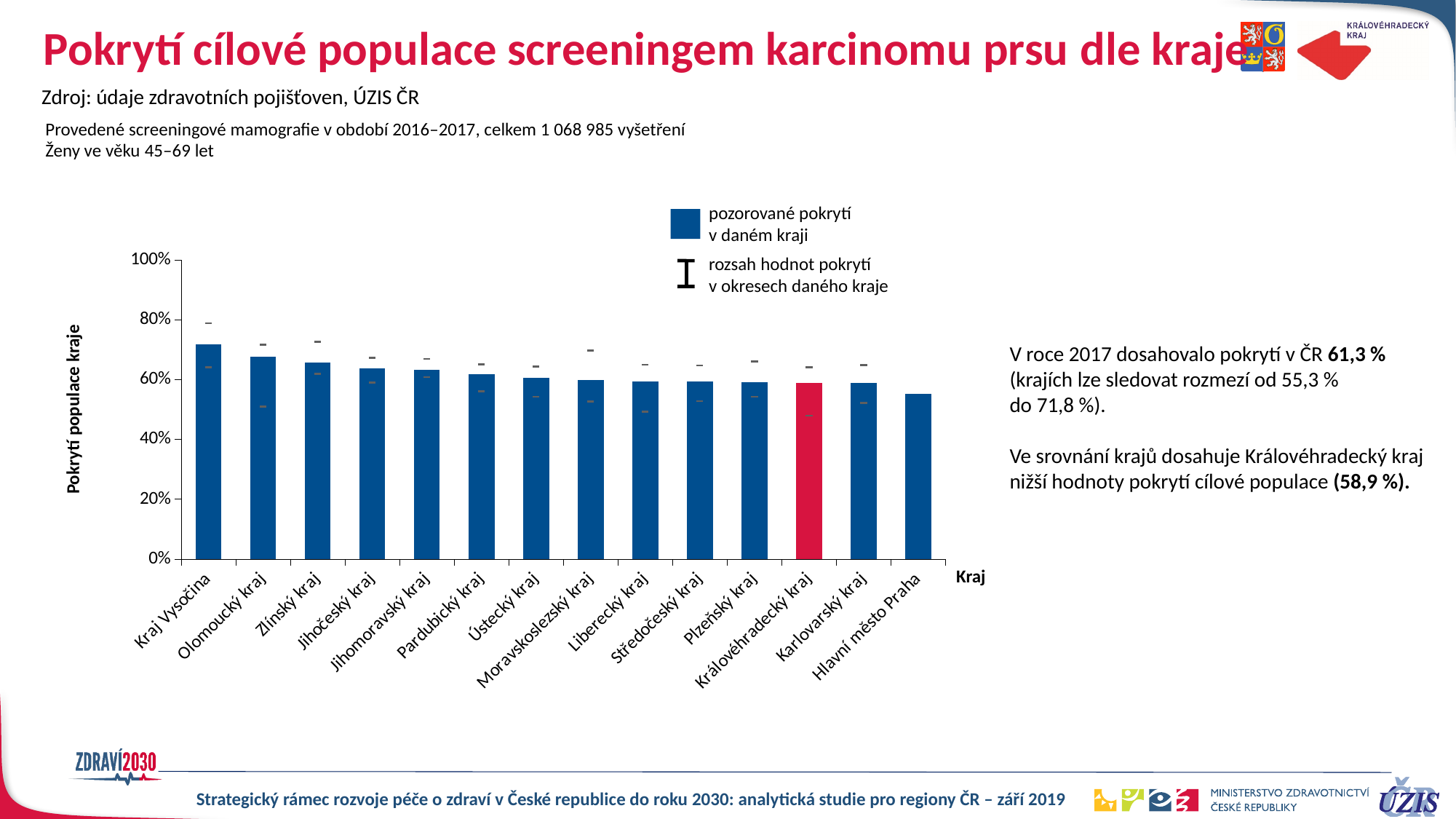
Do the bar values rise or fall from left to right along the x axis? fall Is the value for Hlavní město Praha greater or less than 60%? less What kind of chart is shown on the slide? bar chart Is the value for Kraj Vysočina greater or less than 60%? greater Which region's bar is highlighted in red in the chart? Královéhradecký kraj How many entries does the chart legend list? 2 How many regions (kraje) are plotted on the x axis of the chart? 14 What is the observed coverage for Královéhradecký kraj? 58,9 % Which has a higher observed coverage, Olomoucký kraj or Pardubický kraj? Olomoucký kraj Which region has the highest observed coverage in the chart? Kraj Vysočina Which region has the lowest observed coverage in the chart? Hlavní město Praha